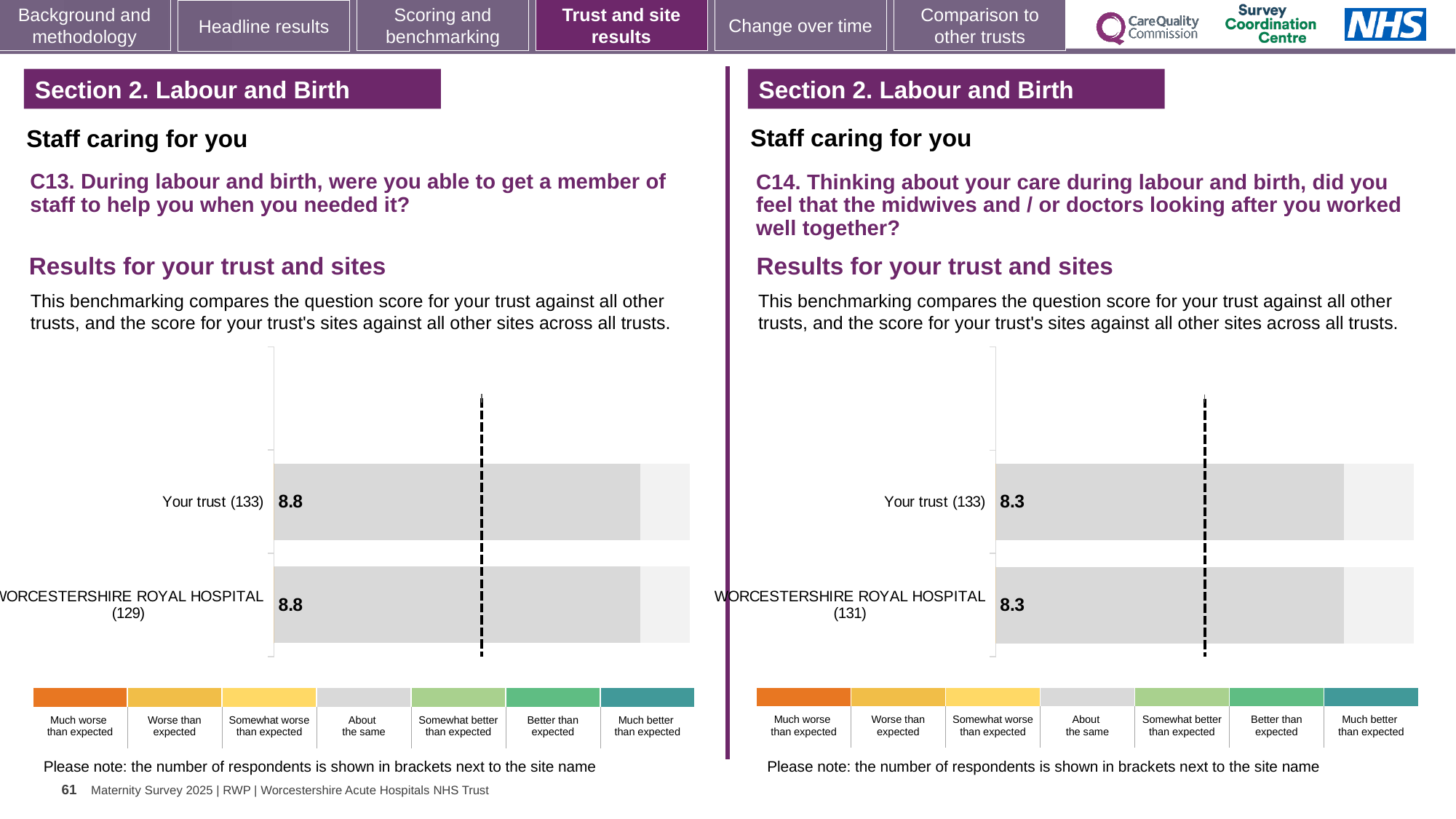
In the left chart (C13), what is the score for Your trust? 8.8 In the left chart (C13), what is the difference between the score for Your trust and the score for Worcestershire Royal Hospital? 0 In the left chart (C13), what is the score for Worcestershire Royal Hospital? 8.8 In the right chart (C14), how many respondents are shown in brackets for Worcestershire Royal Hospital? 131 In the left chart (C13), how many respondents are shown in brackets for Worcestershire Royal Hospital? 129 In the right chart (C14), what is the score for Your trust? 8.3 In the right chart (C14), what is the score for Worcestershire Royal Hospital? 8.3 What kind of chart is used in the left chart (C13)? Bar chart How many bars are plotted in the right chart (C14)? 2 Is the score for Your trust in the left chart (C13) larger or smaller than the score for Your trust in the right chart (C14)? Larger In the right chart (C14), what is the difference between the score for Your trust and the score for Worcestershire Royal Hospital? 0 How many bars are plotted in the left chart (C13)? 2